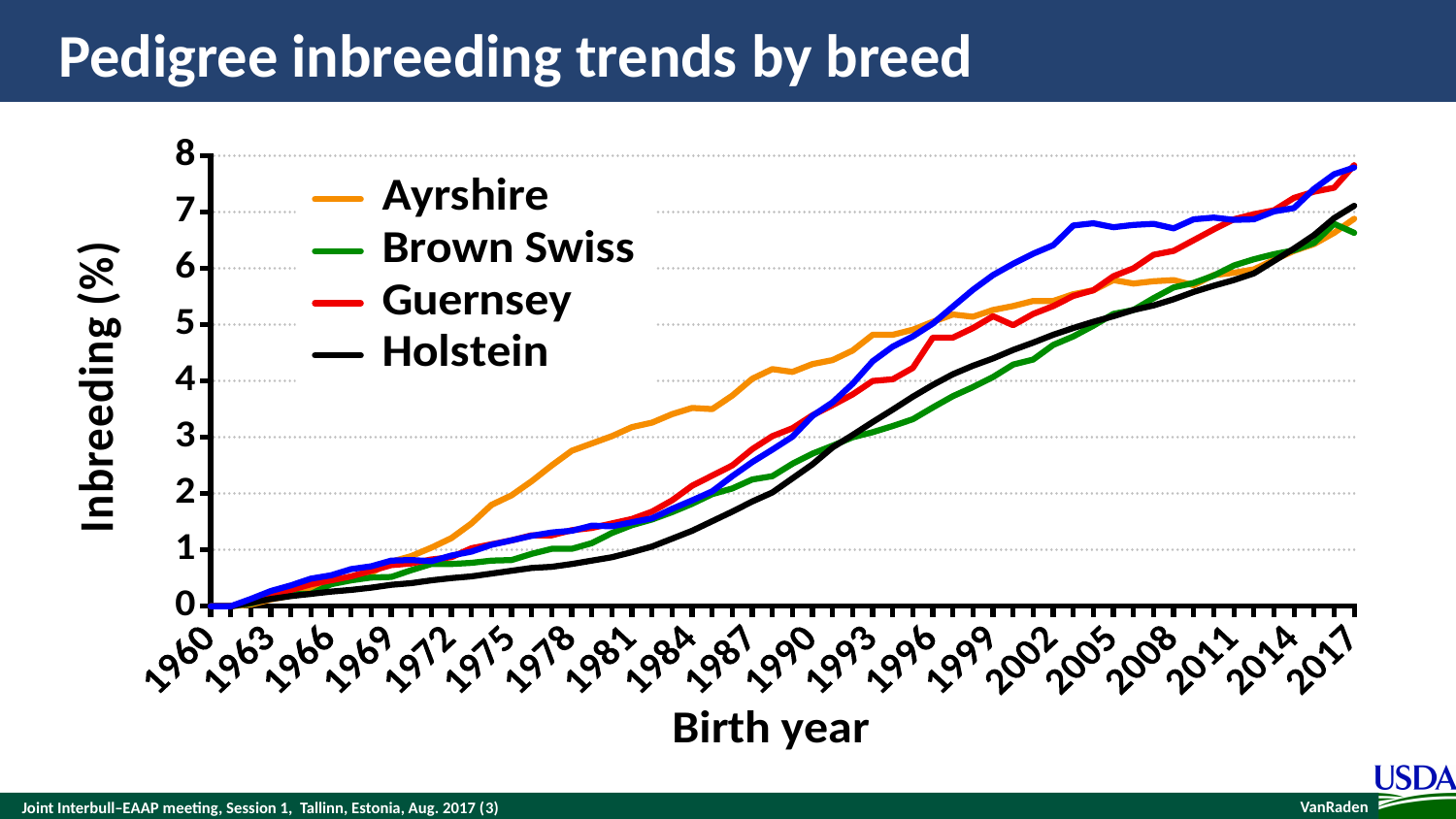
Which of the breeds listed in the legend has the lowest inbreeding value in 1984? Holstein Is the value for Guernsey in 2017 greater or less than 7? greater What kind of chart is shown on the slide? line chart In 1984, which is larger, the value for Ayrshire or the value for Holstein? Ayrshire Do the inbreeding values for Holstein rise or fall from 1960 to 2017? rise Is the value for Ayrshire in 1984 greater or less than 3? greater What is the label of the y axis? Inbreeding (%) Is the value for Brown Swiss in 2017 greater or less than 7? less How many series does the legend list? 4 What is the title of the chart? Pedigree inbreeding trends by breed